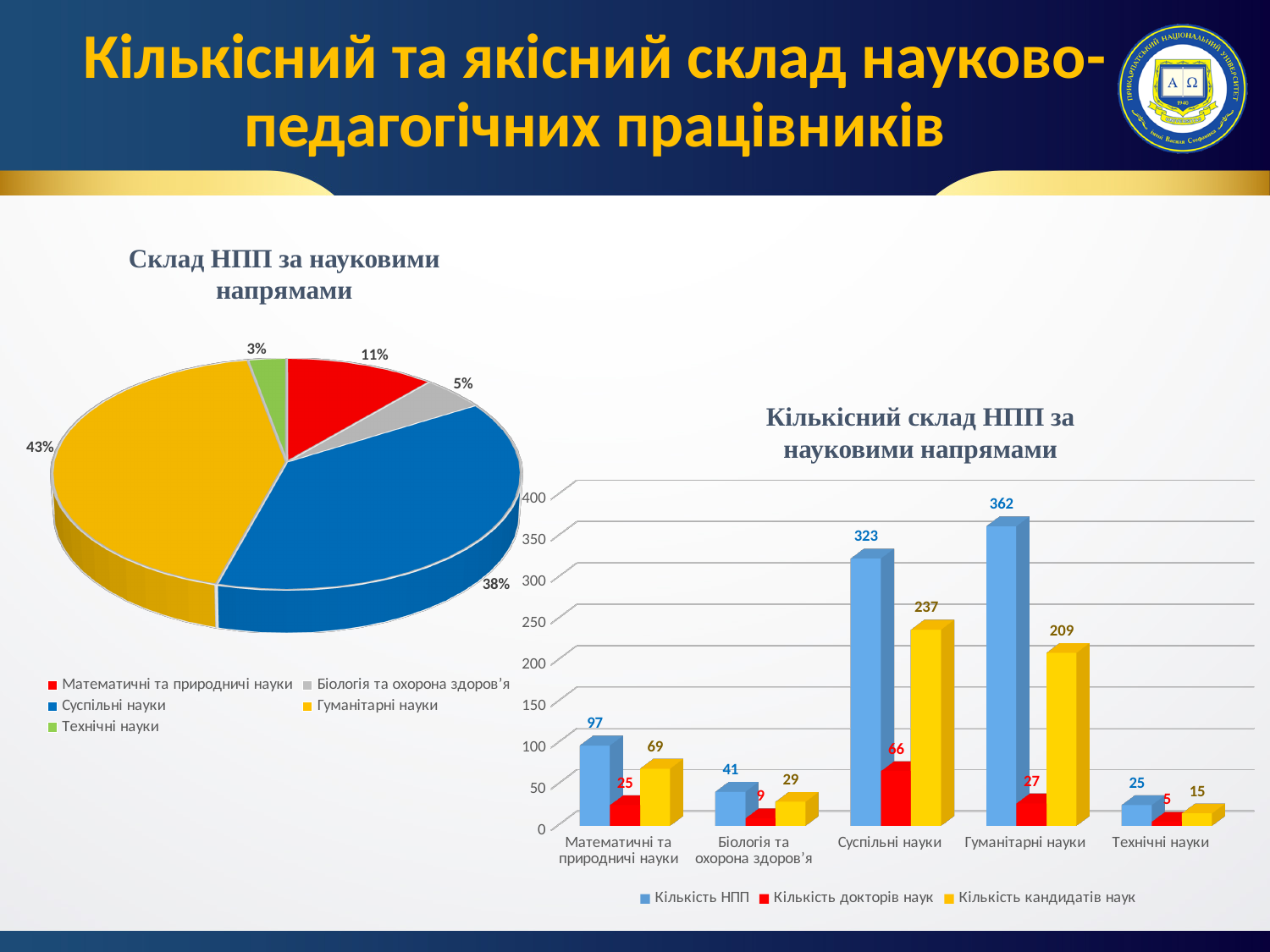
In the pie chart 'Склад НПП за науковими напрямами', which category has the smallest share? Технічні науки In the pie chart 'Склад НПП за науковими напрямами', what share does Суспільні науки have? 38% In the pie chart 'Склад НПП за науковими напрямами', what share does Гуманітарні науки have? 43% In the bar chart 'Кількісний склад НПП за науковими напрямами', what is the difference between Кількість НПП for Гуманітарні науки and Суспільні науки? 39 In the bar chart 'Кількісний склад НПП за науковими напрямами', what is the value of Кількість докторів наук for Технічні науки? 5 In the bar chart 'Кількісний склад НПП за науковими напрямами', which is larger: Кількість кандидатів наук for Математичні та природничі науки or for Біологія та охорона здоров'я? Математичні та природничі науки In the bar chart 'Кількісний склад НПП за науковими напрямами', what is the value of Кількість кандидатів наук for Суспільні науки? 237 What type of chart is 'Кількісний склад НПП за науковими напрямами'? Bar chart In the bar chart 'Кількісний склад НПП за науковими напрямами', how many series does the legend list? 3 In the pie chart 'Склад НПП за науковими напрямами', how many categories does the legend list? 5 In the bar chart 'Кількісний склад НПП за науковими напрямами', which category has the highest value of Кількість докторів наук? Суспільні науки In the bar chart 'Кількісний склад НПП за науковими напрямами', what is the value of Кількість НПП for Гуманітарні науки? 362